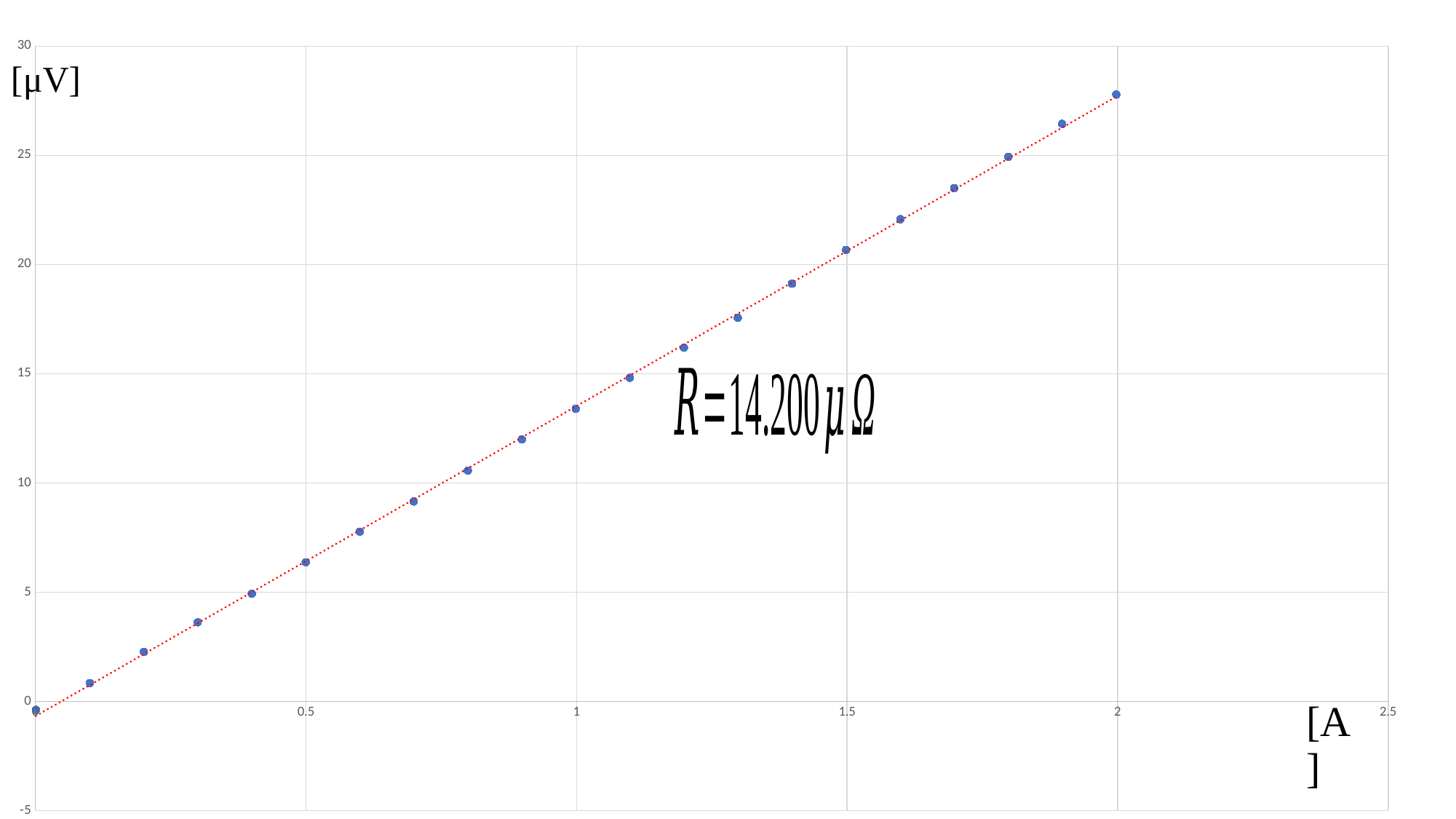
Is the value at 0.5 A greater or less than 5? greater Do the plotted values rise or fall as the current on the x axis increases? Rise At which x-axis value (in A) is the plotted voltage lowest? 0 What unit is shown on the y axis of the chart? [μV] Which is larger, the value at 1.5 A or the value at 1 A? The value at 1.5 A Is the value at 2 A greater or less than 25? greater What kind of chart is shown on the slide? Scatter chart with a trend line What resistance value is annotated on the chart? R=14.200 μΩ At which x-axis value (in A) is the plotted voltage highest? 2 How many data points are plotted on the chart? 21 Is the value at 1.5 A greater or less than 20? greater